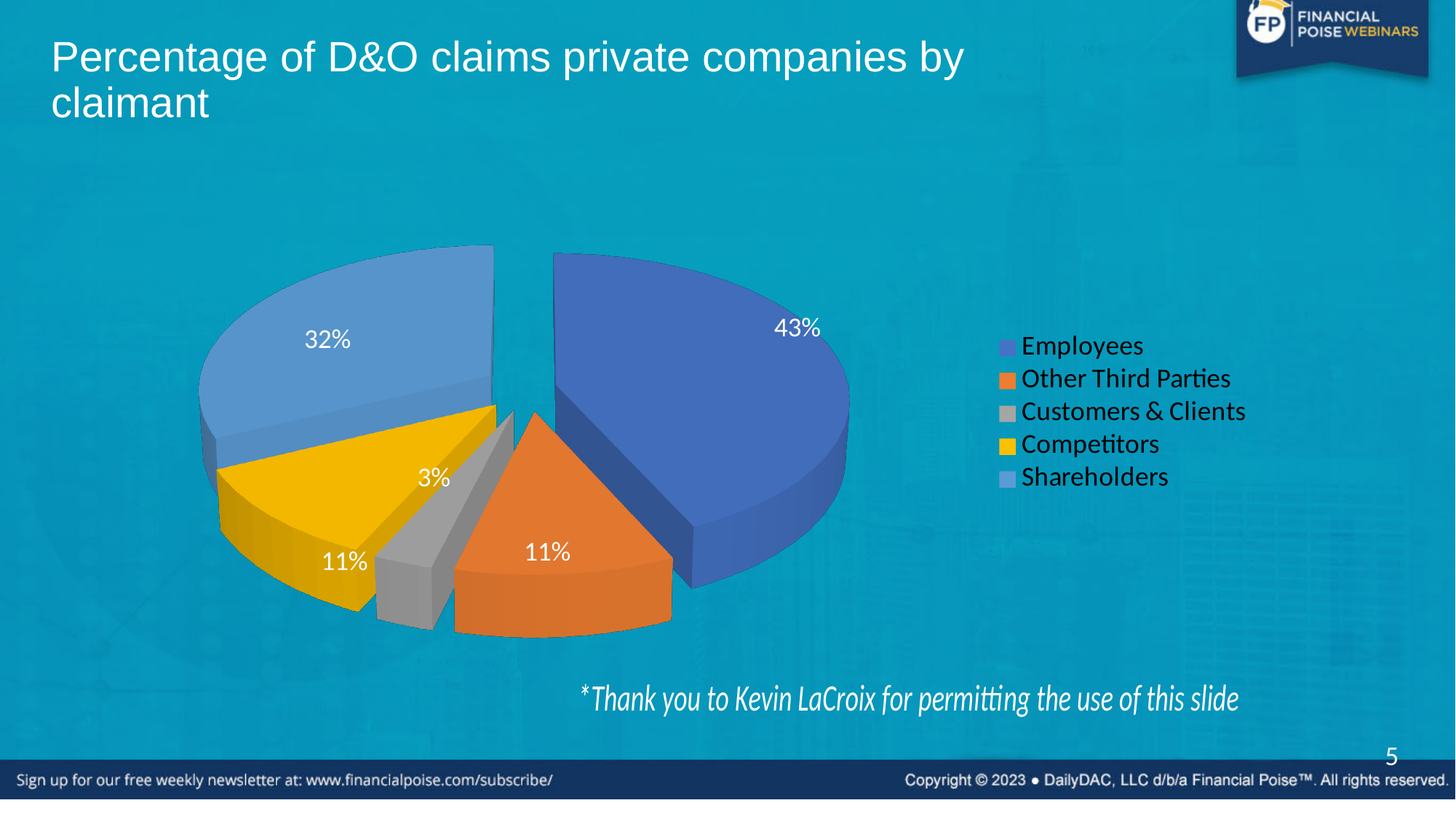
What is the difference in percentage points between the Employees share and the Shareholders share? 11 What kind of chart is shown on the slide? Pie chart How many claimant categories does the legend list? 5 What percentage of D&O claims come from Employees? 43% What percentage of D&O claims come from Customers & Clients? 3% Which has a larger share of D&O claims, Shareholders or Other Third Parties? Shareholders What colour is the Competitors slice? Yellow What percentage of D&O claims come from Shareholders? 32% What is the combined share of Other Third Parties and Competitors? 22% What percentage of D&O claims come from Competitors? 11% Which claimant category has the smallest share of D&O claims? Customers & Clients Which claimant category has the largest share of D&O claims? Employees